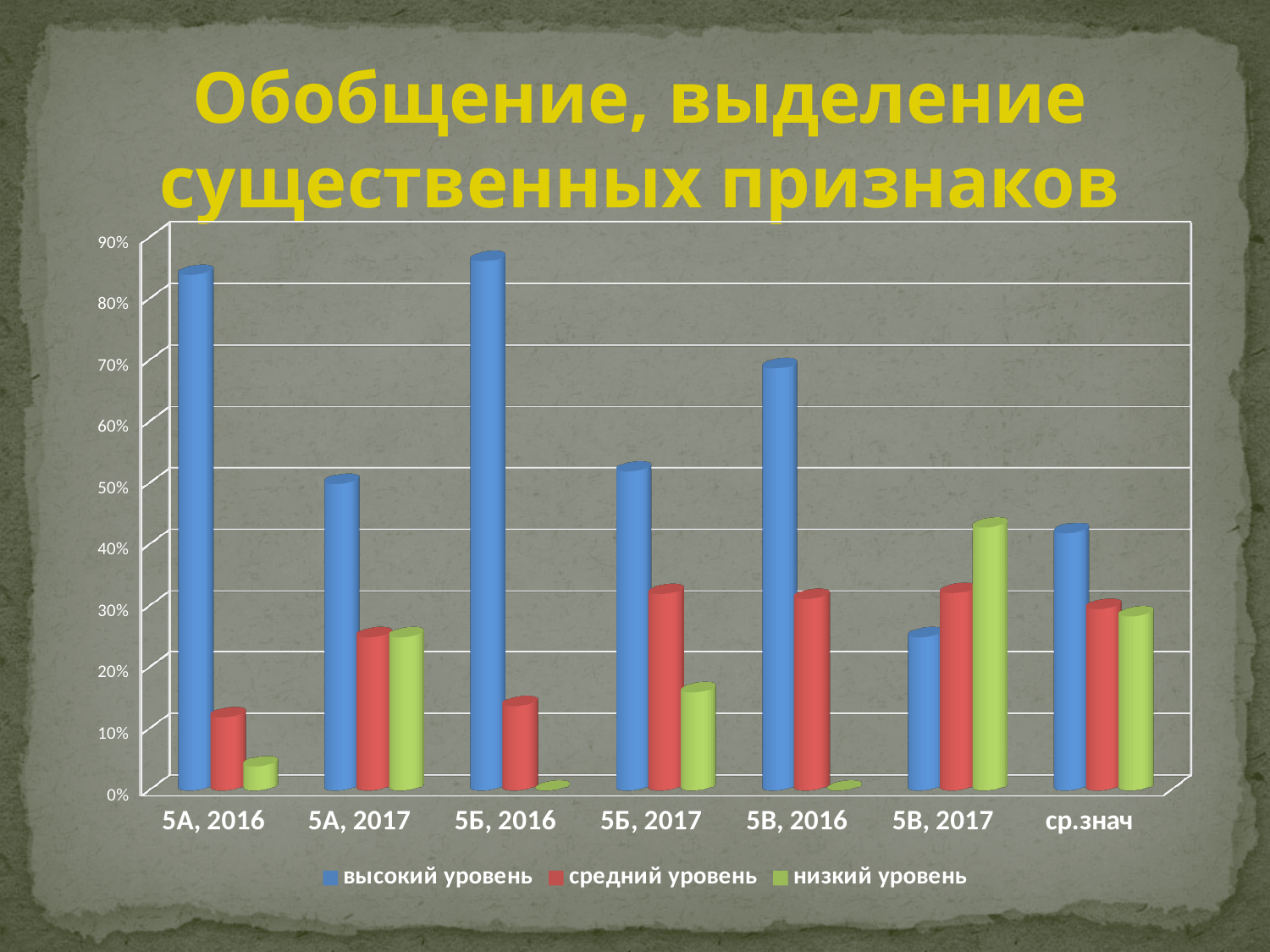
Which category has the lowest value for the 'высокий уровень' series? 5В, 2017 Is the 'высокий уровень' value for '5В, 2016' greater or less than 60%? greater Is the 'низкий уровень' value for '5А, 2016' greater or less than 10%? less Which category has the highest value for the 'низкий уровень' series? 5В, 2017 How many categories are shown along the x axis of the chart? 7 Is the 'высокий уровень' value for 'ср.знач' greater or less than 50%? less Which is larger: the 'высокий уровень' value for '5Б, 2016' or for '5В, 2016'? 5Б, 2016 How many series does the chart legend list? 3 What kind of chart is shown on the slide? bar chart For '5В, 2017', which is larger: the 'высокий уровень' value or the 'низкий уровень' value? низкий уровень Which colour represents the 'средний уровень' series in the chart? red